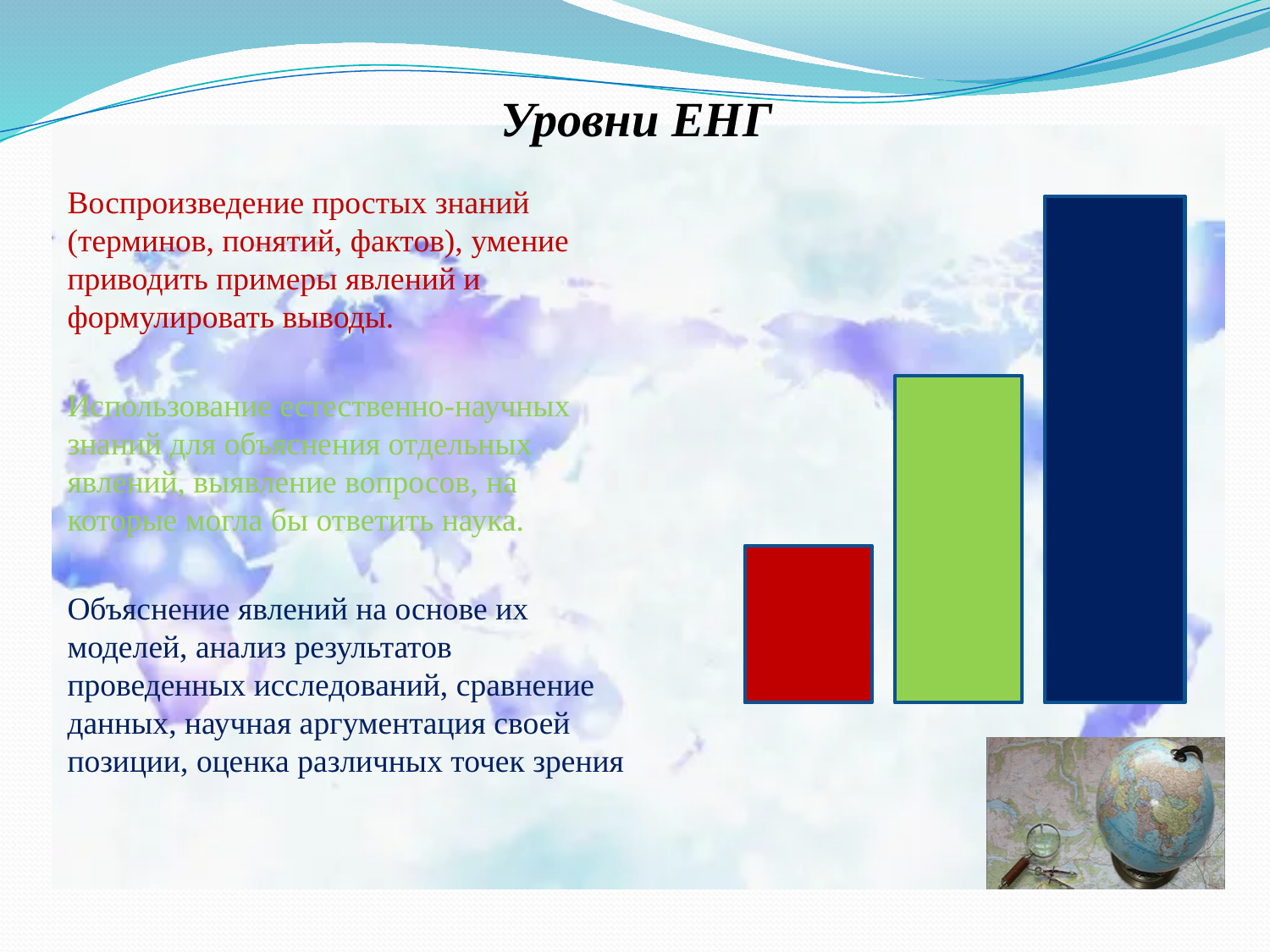
Which is taller, the green bar or the red bar? the green bar How many bars does the chart on the slide contain? 3 What colour is the leftmost bar in the chart? red What kind of chart is shown on the slide? bar chart Which is taller, the dark blue bar or the green bar? the dark blue bar Which bar in the chart is the shortest? the red bar Which bar in the chart is the tallest? the dark blue bar Do the bar heights rise or fall from left to right across the chart? rise What is the title of the slide containing the chart? Уровни ЕНГ